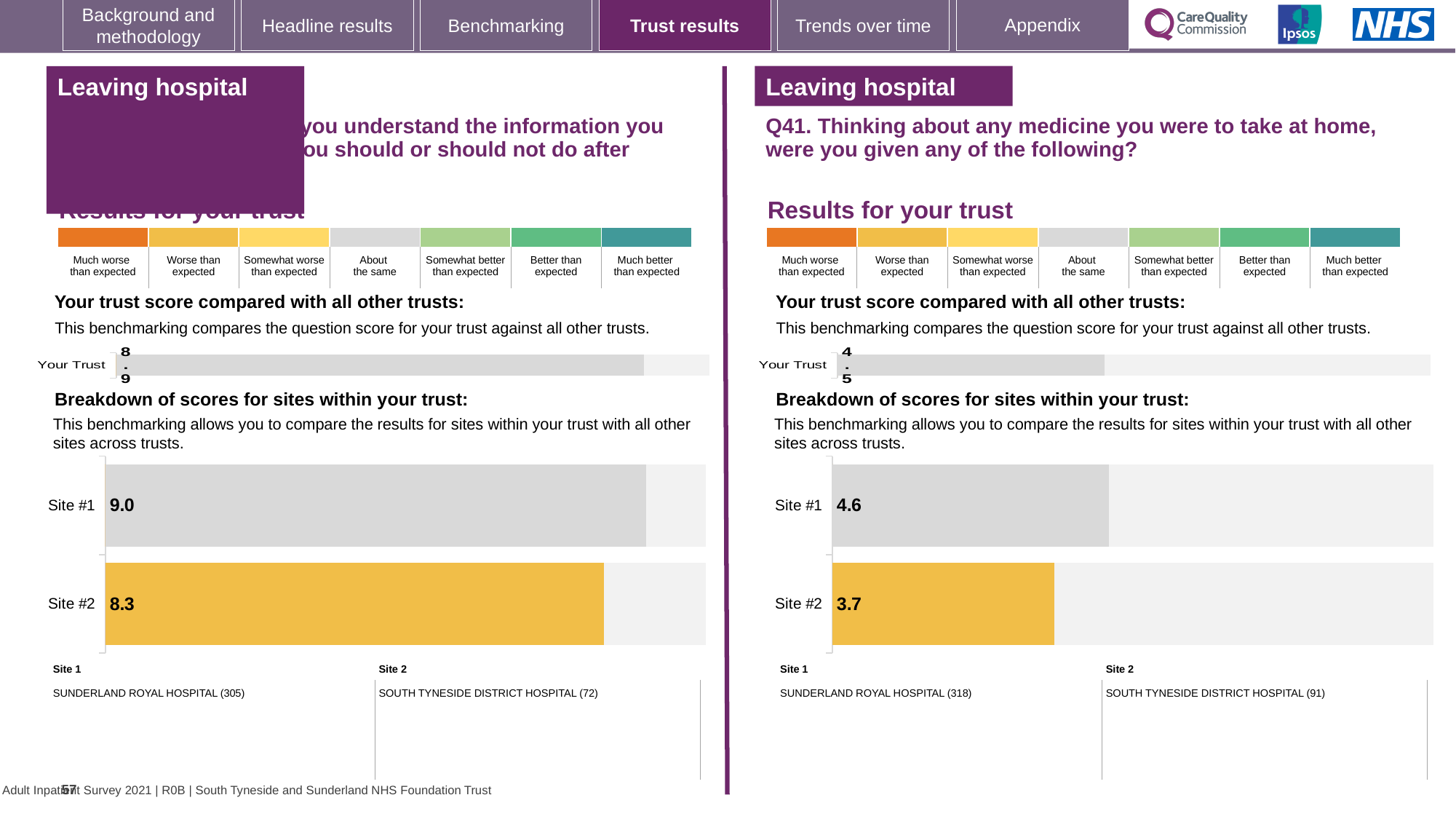
On the left-hand site breakdown chart, which site has the higher score? Site #1 What type of chart is used for the site breakdown on the left-hand side of the slide? Bar chart On the right-hand chart for Q41 (breakdown of scores for sites), what is the score for Site #2? 3.7 On the left-hand site breakdown chart, what is the difference between the Site #1 and Site #2 scores? 0.7 On the right-hand chart for Q41 (breakdown of scores for sites), what is the score for Site #1? 4.6 How many sites are shown in the right-hand Q41 site breakdown chart? 2 On the left-hand chart (breakdown of scores for sites), what is the score for Site #1? 9.0 On the right-hand chart for Q41, what is the 'Your Trust' score compared with all other trusts? 4.5 On the right-hand Q41 site breakdown chart, which site has the lower score? Site #2 On the left-hand chart (breakdown of scores for sites), what is the score for Site #2? 8.3 On the left-hand chart, what is the 'Your Trust' score compared with all other trusts? 8.9 On the right-hand Q41 site breakdown chart, what is the difference between the Site #1 and Site #2 scores? 0.9